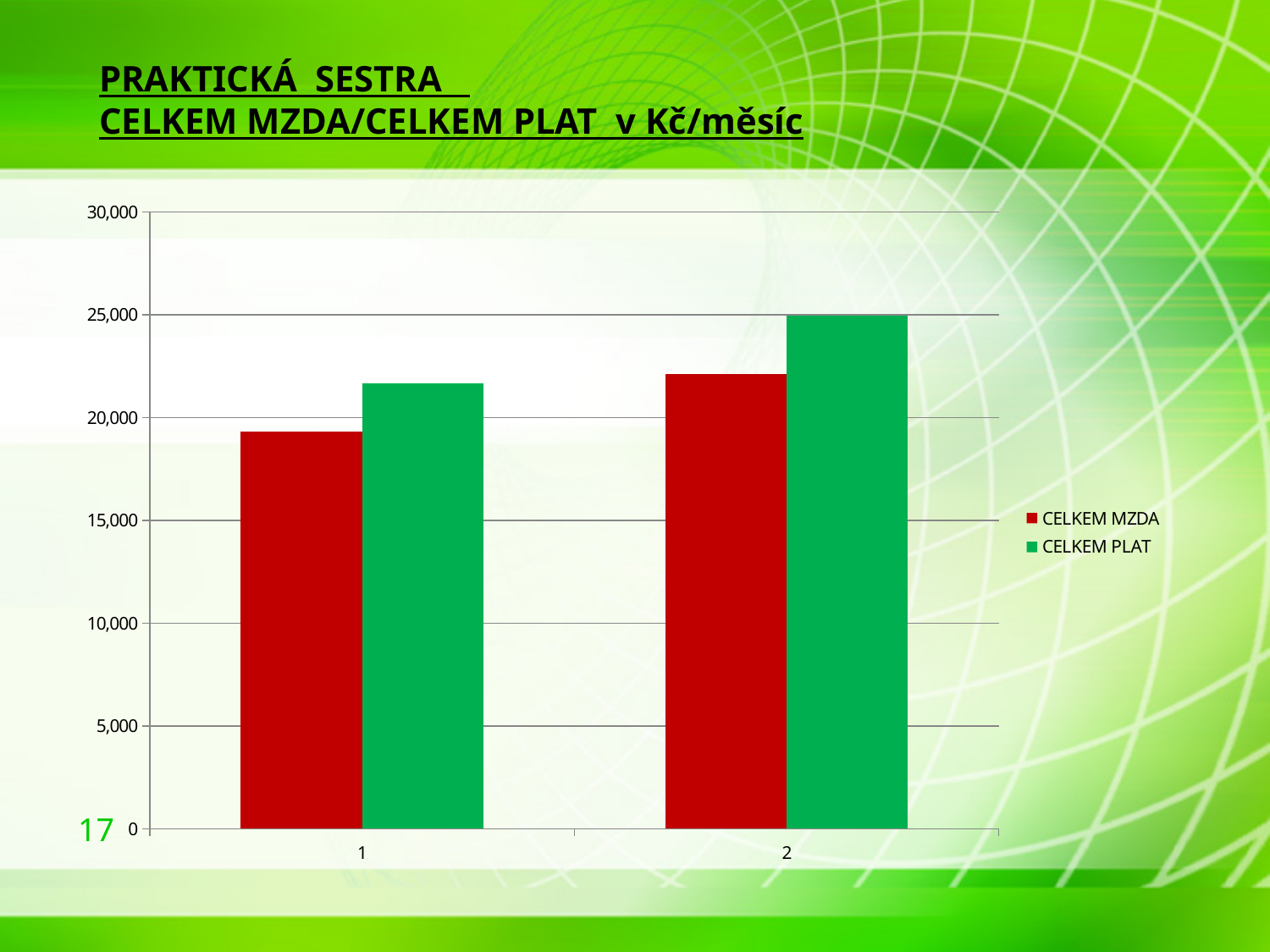
What colour represents the CELKEM PLAT series in the chart? green How many series does the legend list? 2 How many categories are shown on the x axis? 2 Which bar is the shortest in the chart? CELKEM MZDA for category 1 Which series has the higher value for category 1, CELKEM MZDA or CELKEM PLAT? CELKEM PLAT Is the value of CELKEM PLAT for category 1 greater or less than 20,000? greater Which series has the higher value for category 2, CELKEM MZDA or CELKEM PLAT? CELKEM PLAT What kind of chart is shown on the slide? bar chart Is the value of CELKEM MZDA for category 2 greater or less than 20,000? greater Which bar is the tallest in the chart? CELKEM PLAT for category 2 Is the value of CELKEM MZDA for category 1 greater or less than 20,000? less Do the CELKEM MZDA values rise or fall from category 1 to category 2? rise